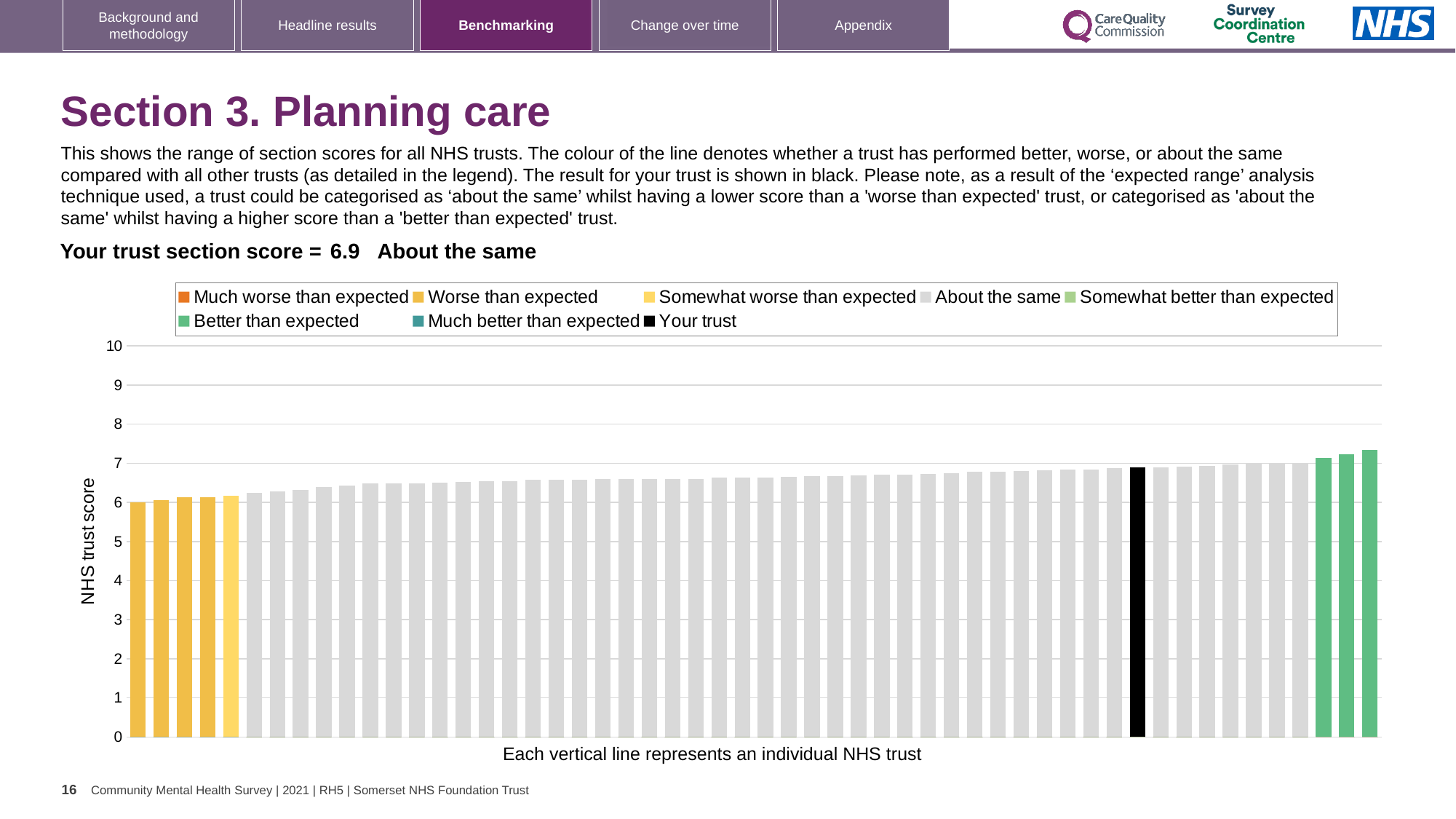
What does the text below the horizontal axis say each vertical line represents? an individual NHS trust How many entries does the chart legend list? 8 How many bars are coloured green (Better than expected) in the chart? 3 What is the label on the vertical axis of the chart? NHS trust score What is the section score for your trust shown on the slide? 6.9 Is the value of the lowest bar in the chart greater or less than 5? greater Is the value for your trust (the black bar) greater or less than 7? less What kind of chart is shown on the slide? bar chart Do the bar values rise or fall from left to right along the x axis? rise Is the value for your trust (the black bar) greater or less than 6? greater Which benchmarking category is your trust placed in for Section 3. Planning care? About the same